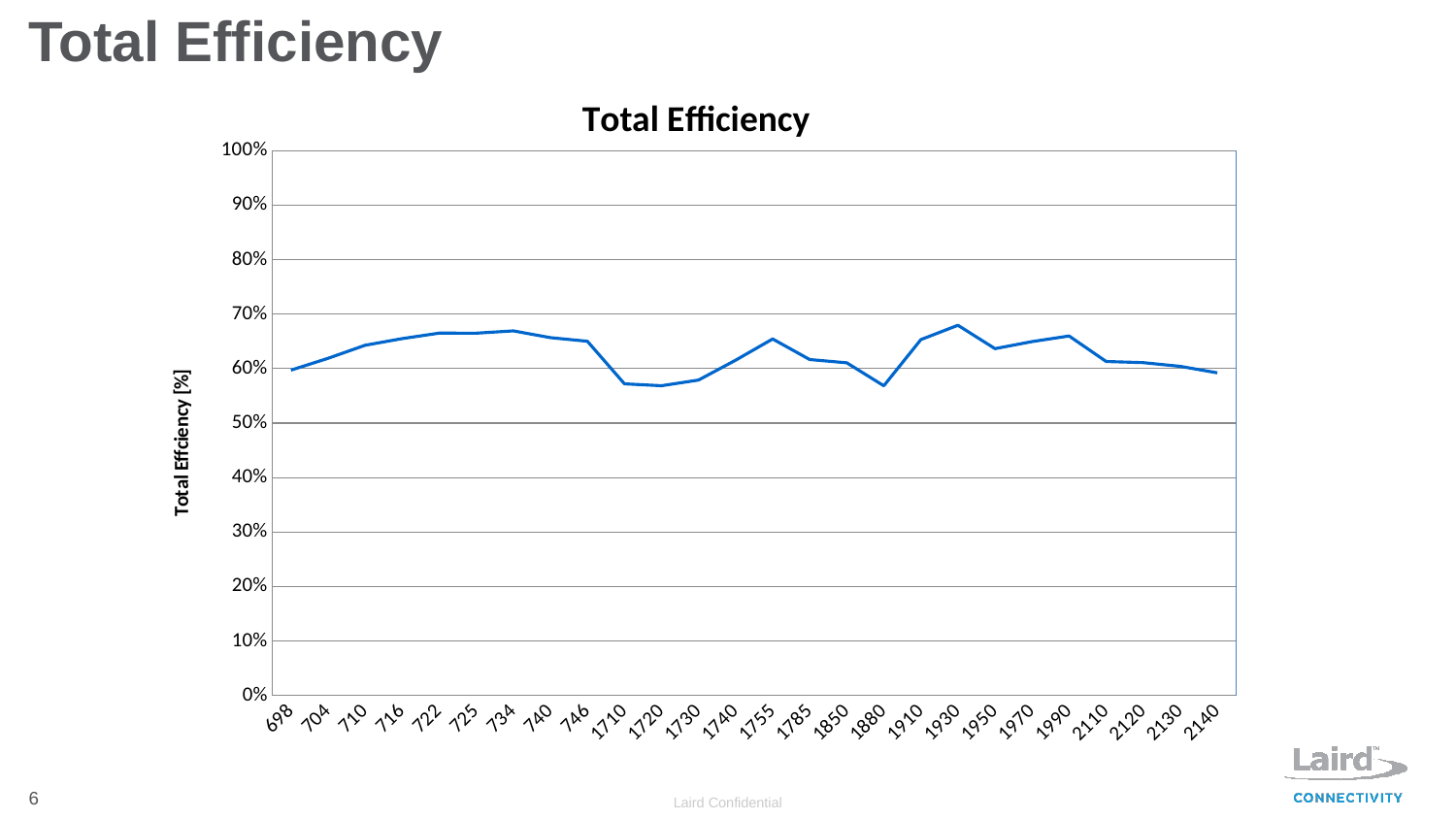
What is the title of the chart? Total Efficiency What is the label on the vertical axis of the chart? Total Efficiency [%] Is the value for 1930 greater or less than 70%? less Does the total efficiency rise or fall from 698 to 734? rise What kind of chart is shown on the slide? line chart Is the value for 1880 greater or less than 60%? less Is the value for 734 greater or less than 60%? greater How many data points are plotted along the x axis? 26 Does the total efficiency rise or fall from 1990 to 2140? fall Which has the higher total efficiency, 1930 or 1880? 1930 Which has the higher total efficiency, 734 or 1720? 734